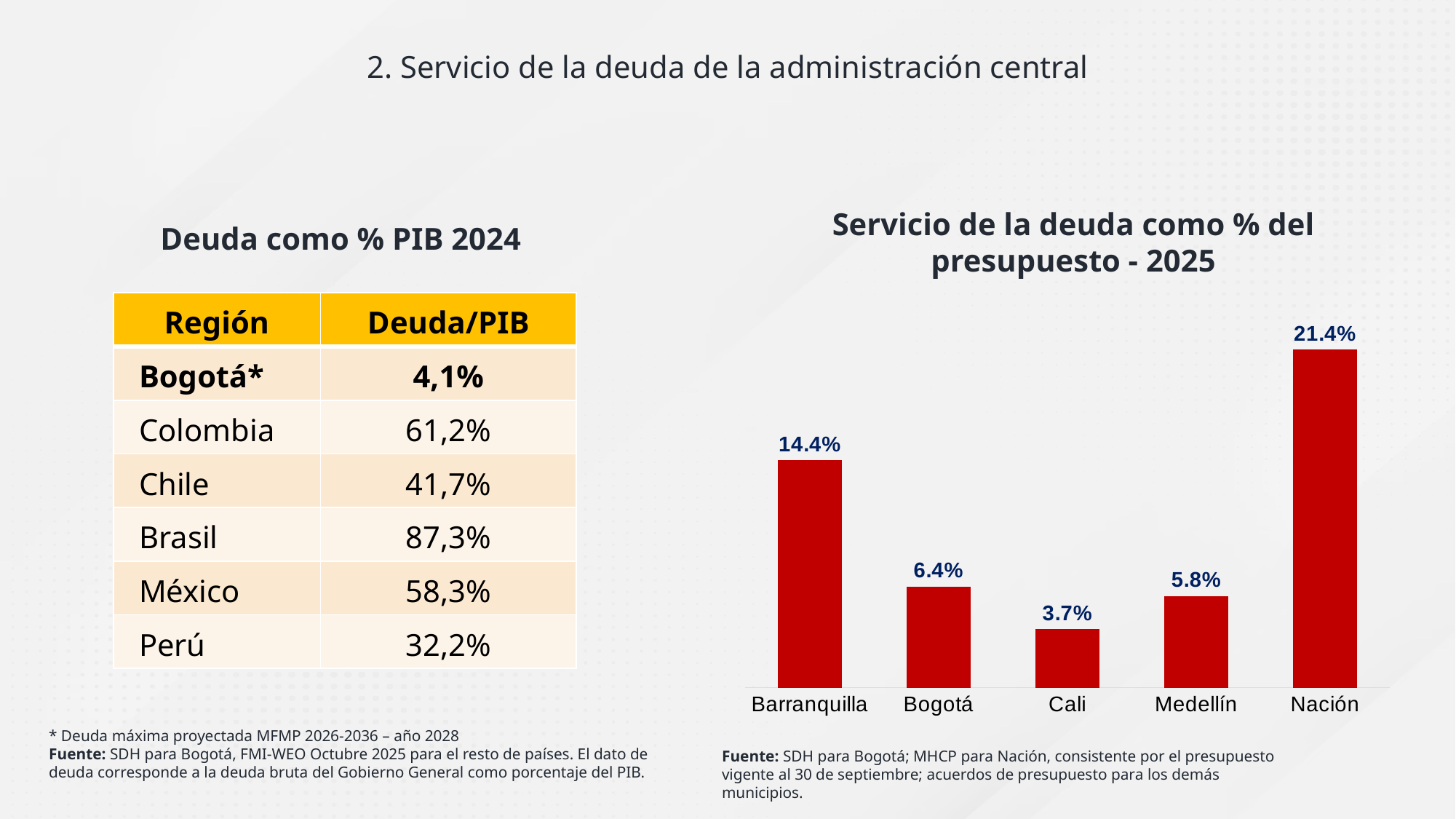
In the bar chart, what is the value for Medellín? 5.8% In the bar chart, which category has the highest value? Nación What type of chart is shown under the title "Servicio de la deuda como % del presupuesto - 2025"? bar chart In the bar chart, what is the difference between the values for Nación and Barranquilla? 7.0% In the bar chart, what is the value for Nación? 21.4% In the bar chart, what is the value for Cali? 3.7% What is the title of the bar chart on the slide? Servicio de la deuda como % del presupuesto - 2025 How many categories are shown in the bar chart? 5 In the bar chart, what is the value for Barranquilla? 14.4% In the bar chart, what is the value for Bogotá? 6.4% In the bar chart, which category has the lowest value? Cali In the bar chart, which is larger, the value for Bogotá or the value for Medellín? Bogotá